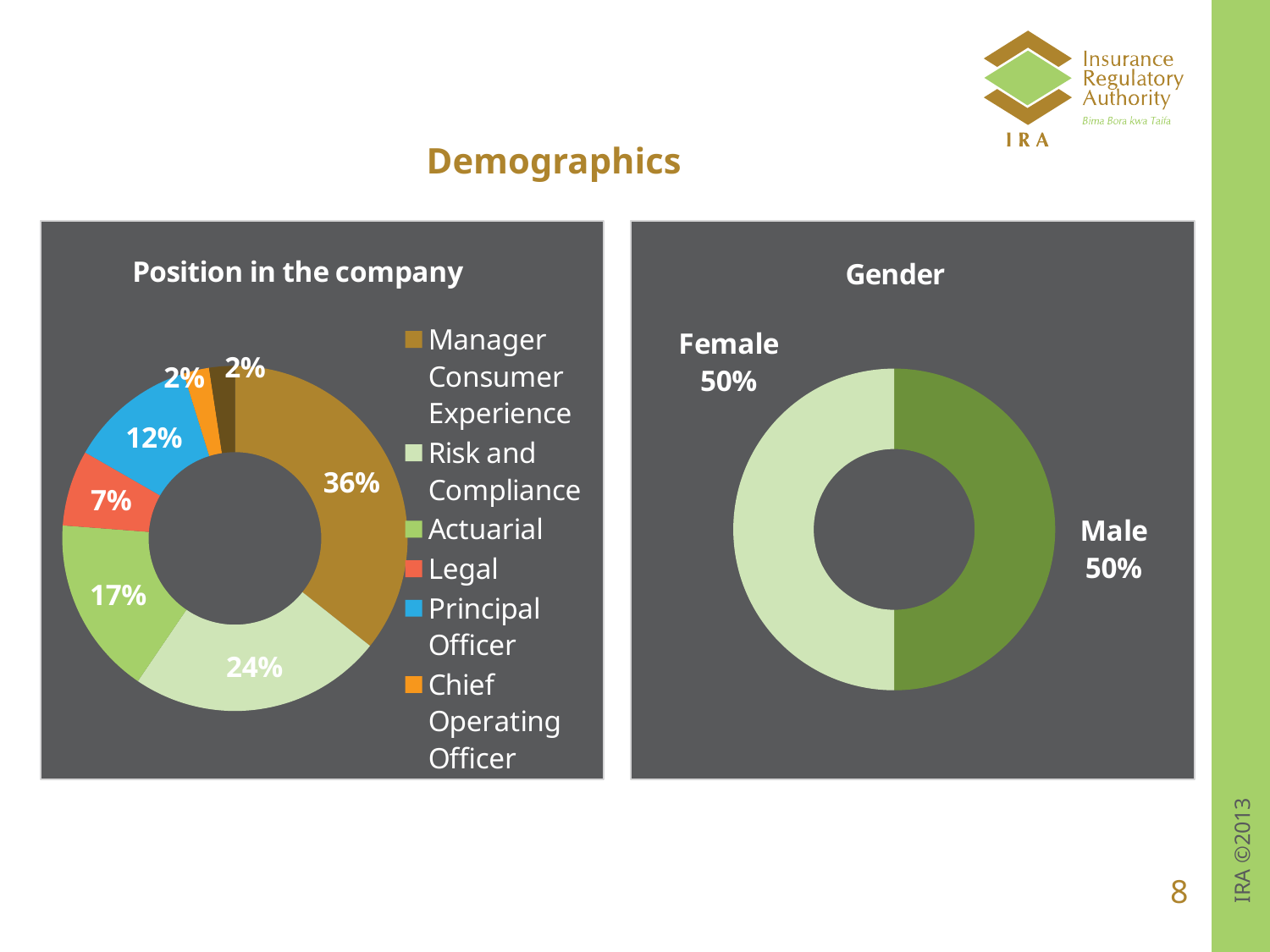
In the 'Position in the company' chart, what percentage is shown for Legal? 7% In the 'Gender' chart, what percentage is shown for Male? 50% In the 'Position in the company' chart, what percentage is shown for Principal Officer? 12% In the 'Position in the company' chart, what share is labelled for Manager Consumer Experience? 36% In the 'Position in the company' chart, which position has the largest share? Manager Consumer Experience How many entries does the legend of the 'Position in the company' chart list? 6 In the 'Position in the company' chart, how many percentage points larger is Risk and Compliance than Actuarial? 7 percentage points In the 'Position in the company' chart, which has the larger share, Principal Officer or Legal? Principal Officer What type of chart is the 'Position in the company' chart? Doughnut chart In the 'Gender' chart, what percentage is shown for Female? 50% In the 'Position in the company' chart, what percentage is shown for Risk and Compliance? 24% In the 'Position in the company' chart, what percentage is shown for Actuarial? 17%